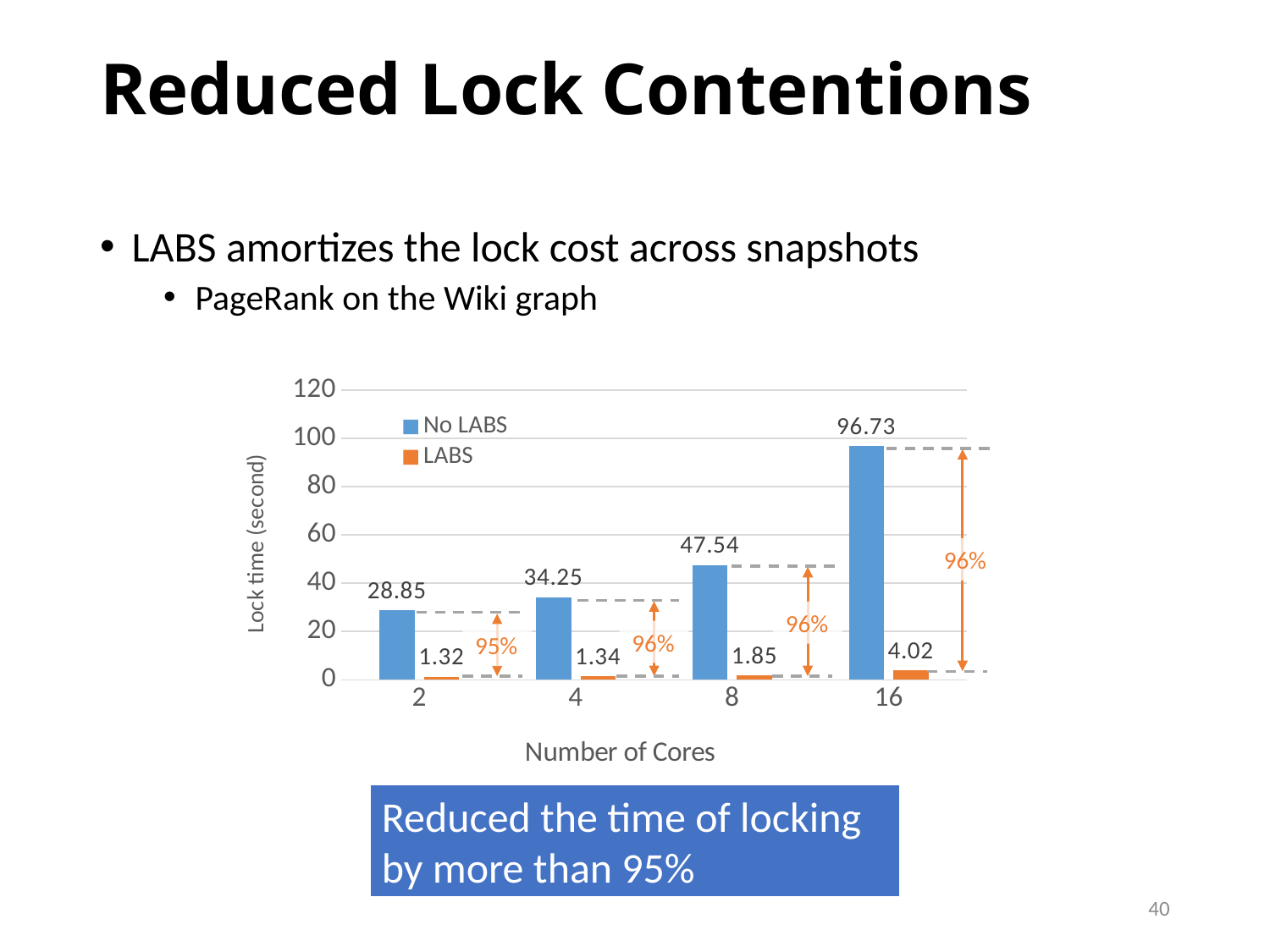
Which is larger, the No LABS lock time at 8 cores or at 4 cores? 8 cores Is the No LABS lock time at 8 cores greater or less than 40? greater How many series does the legend list? 2 What is the difference between the No LABS and LABS lock times at 4 cores? 32.91 At which number of cores is the No LABS lock time highest? 16 What is the lock time for LABS at 8 cores? 1.85 What is the lock time for No LABS at 2 cores? 28.85 What is the lock time for No LABS at 16 cores? 96.73 What kind of chart is shown? bar chart At which number of cores is the LABS lock time lowest? 2 How many core counts are shown on the x axis? 4 Does the No LABS lock time rise or fall as the number of cores increases? rise